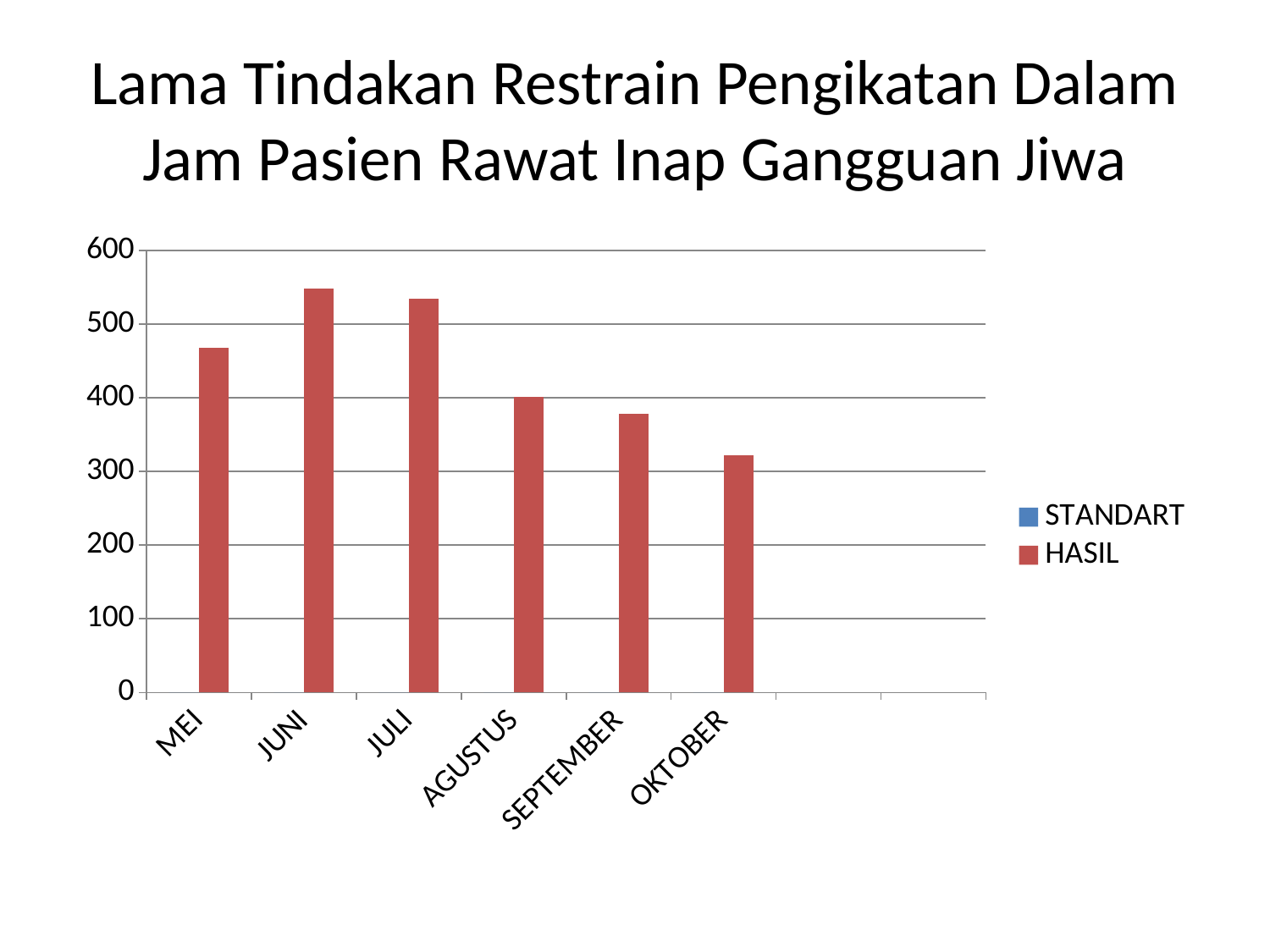
What kind of chart is shown on the slide? bar chart Is the HASIL value for MEI greater or less than 400? greater How many months are shown on the x axis of the chart? 6 Which is larger, the HASIL value for MEI or for AGUSTUS? MEI Is the HASIL value for SEPTEMBER greater or less than 400? less What are the two entries listed in the chart's legend? STANDART and HASIL Do the HASIL values rise or fall from JULI to OKTOBER? fall Which is larger, the HASIL value for JULI or for SEPTEMBER? JULI Which month has the lowest HASIL value? OKTOBER Is the HASIL value for OKTOBER greater or less than 300? greater How many series does the chart's legend list? 2